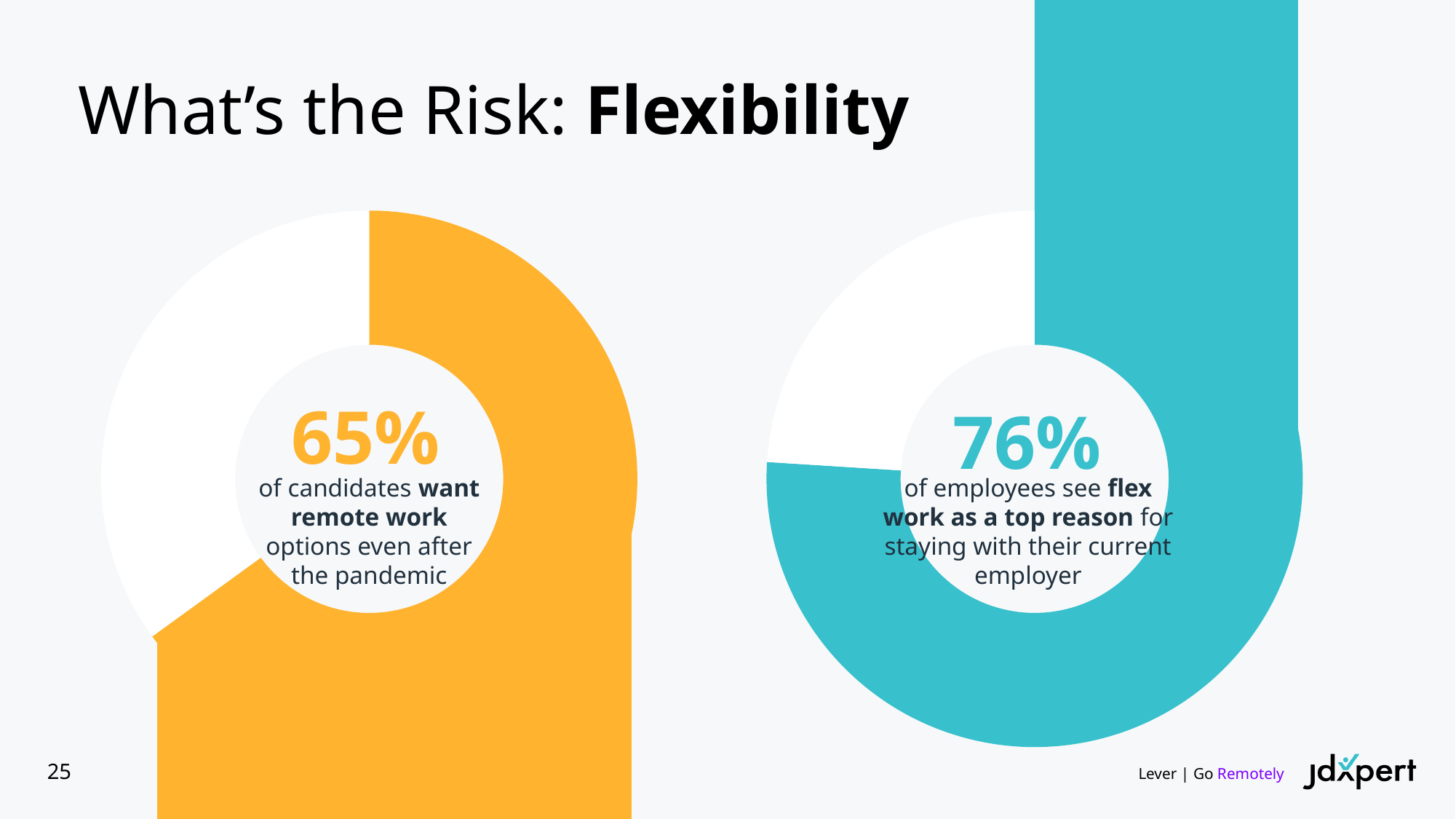
What colour is the filled portion of the right chart? Teal What is the title of the slide containing the two donut charts? What's the Risk: Flexibility Is the value shown on the left chart greater or less than 50%? greater How many donut charts are shown on the slide? 2 What is the difference in percentage points between the value on the right chart (76%) and the value on the left chart (65%)? 11 percentage points On the right chart, what percentage of employees see flex work as a top reason for staying with their current employer? 76% Is the value shown on the right chart greater or less than 80%? less What kind of chart is used on the left side of the slide to show the 65% figure? Donut (pie) chart Which is larger: the percentage of candidates who want remote work options (left chart) or the percentage of employees who see flex work as a top reason for staying (right chart)? 76% of employees (right chart) On the left chart, what share of the donut is filled in orange? 65% On the right chart, what share of the donut is filled in teal? 76% On the left chart, what percentage of candidates want remote work options even after the pandemic? 65%